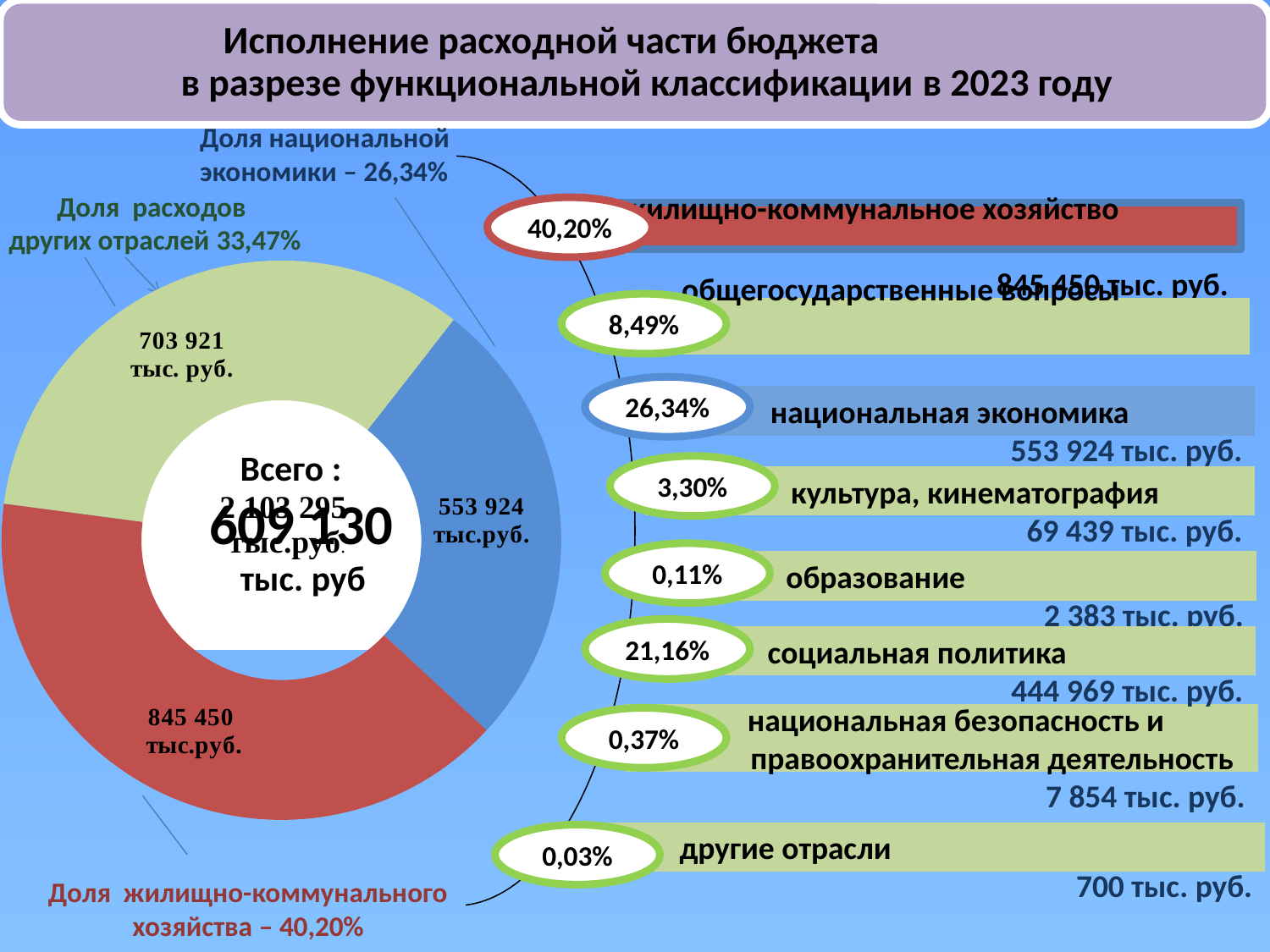
What kind of chart is shown on the left of the slide? pie chart (doughnut) What value is labelled on the green slice of the doughnut chart (другие отрасли)? 703 921 тыс. руб. Which slice of the doughnut chart is the smallest? национальная экономика (553 924 тыс.руб.) What value is labelled on the blue slice of the doughnut chart (национальная экономика)? 553 924 тыс.руб. In the doughnut chart, which is larger: the green slice (другие отрасли) or the blue slice (национальная экономика)? the green slice (другие отрасли) What share of the doughnut chart do расходы других отраслей represent? 33,47% What share of the doughnut chart does национальная экономика represent? 26,34% What share of the doughnut chart does жилищно-коммунальное хозяйство represent? 40,20% Which slice of the doughnut chart is the largest? жилищно-коммунальное хозяйство (845 450 тыс.руб.) How many slices does the doughnut chart have? 3 What is the difference between the red slice (845 450 тыс.руб.) and the blue slice (553 924 тыс.руб.) in the doughnut chart? 291 526 тыс.руб. What value is labelled on the red slice of the doughnut chart (жилищно-коммунальное хозяйство)? 845 450 тыс.руб.